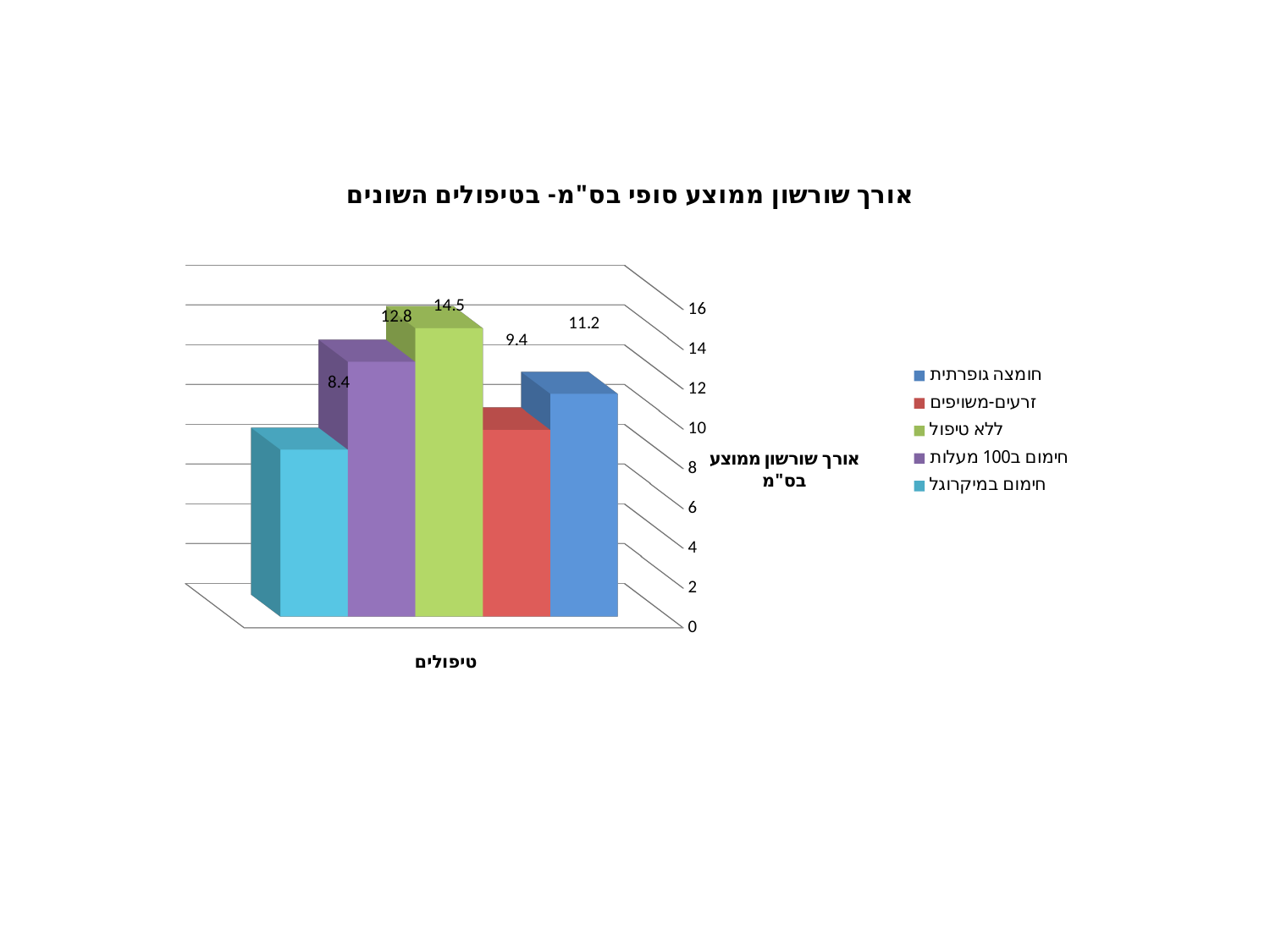
What is the title of the chart? אורך שורשון ממוצע סופי בס"מ- בטיפולים השונים What is the value for חימום במיקרוגל? 8.4 What is the value for חומצה גופרתית? 11.2 How many series does the legend list? 5 Which treatment has the highest average root length? ללא טיפול What is the difference between the values for ללא טיפול and חימום במיקרוגל? 6.1 Is the value for זרעים-משויפים greater or less than 10? less Which treatment has the lowest average root length? חימום במיקרוגל What type of chart is shown on the slide? bar chart What is the value for ללא טיפול? 14.5 What is the value for חימום ב100 מעלות? 12.8 Which is larger, the value for זרעים-משויפים or the value for חומצה גופרתית? חומצה גופרתית